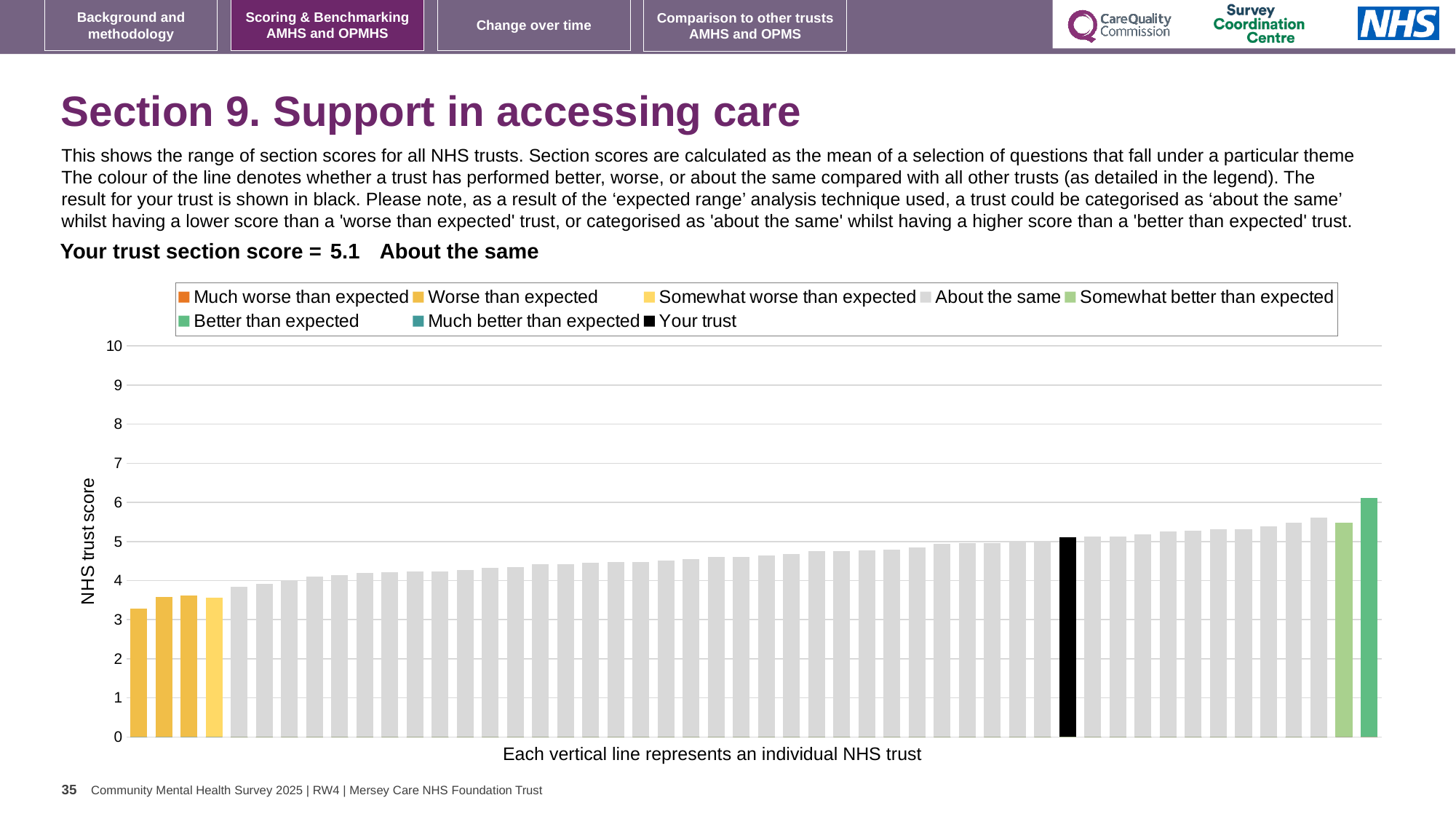
Is the value of the tallest bar greater or less than 7? less What colour is used for the 'Your trust' bar? black Do the bar values rise or fall from left to right along the x axis? rise What kind of chart is shown on the slide? bar chart Which performance category is your trust placed in for this section? About the same What is the section score for your trust? 5.1 How many entries does the chart legend list? 8 How many bars are coloured yellow at the left of the chart? 4 Which legend category does the tallest bar belong to? Better than expected Is the value of the black bar (your trust) greater or less than 4? greater What is the title of the vertical axis? NHS trust score Is the value of the shortest bar greater or less than 4? less